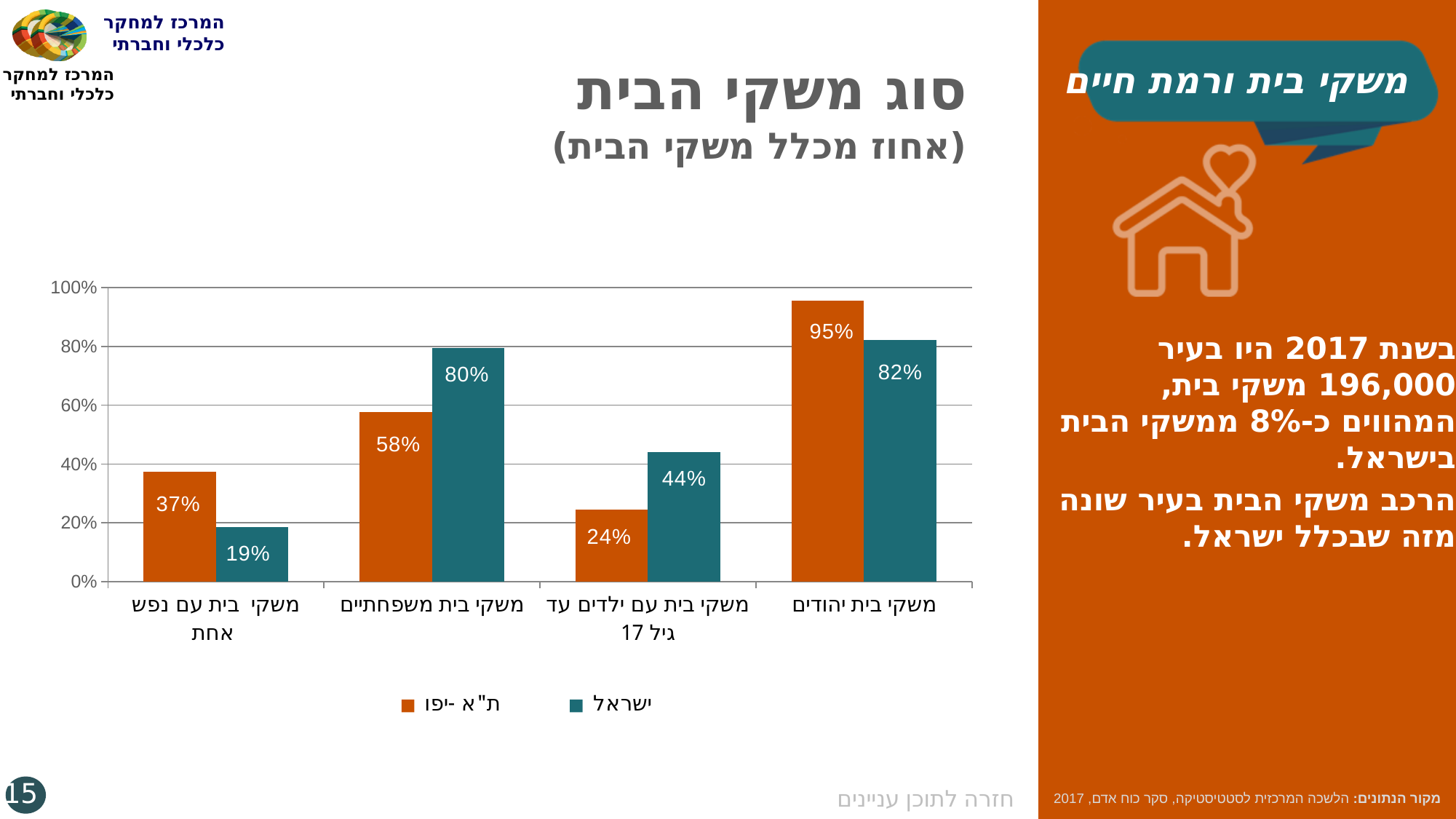
What is the value for ישראל in the category משקי בית משפחתיים? 80% What is the value for ישראל in the category משקי בית יהודים? 82% How many series does the chart legend list? 2 Which category has the lowest value for ישראל? משקי בית עם נפש אחת How many categories are shown on the x axis of the chart? 4 What is the value for ת"א -יפו in the category משקי בית עם נפש אחת? 37% What is the value for ת"א -יפו in the category משקי בית עם ילדים עד גיל 17? 24% In the category משקי בית עם ילדים עד גיל 17, which series has the larger value, ת"א -יפו or ישראל? ישראל Which colour represents the series ישראל in the chart? teal What kind of chart is shown on the slide? bar chart Which category has the highest value for ת"א -יפו? משקי בית יהודים What is the difference between the ישראל and ת"א -יפו values in the category משקי בית משפחתיים? 22%